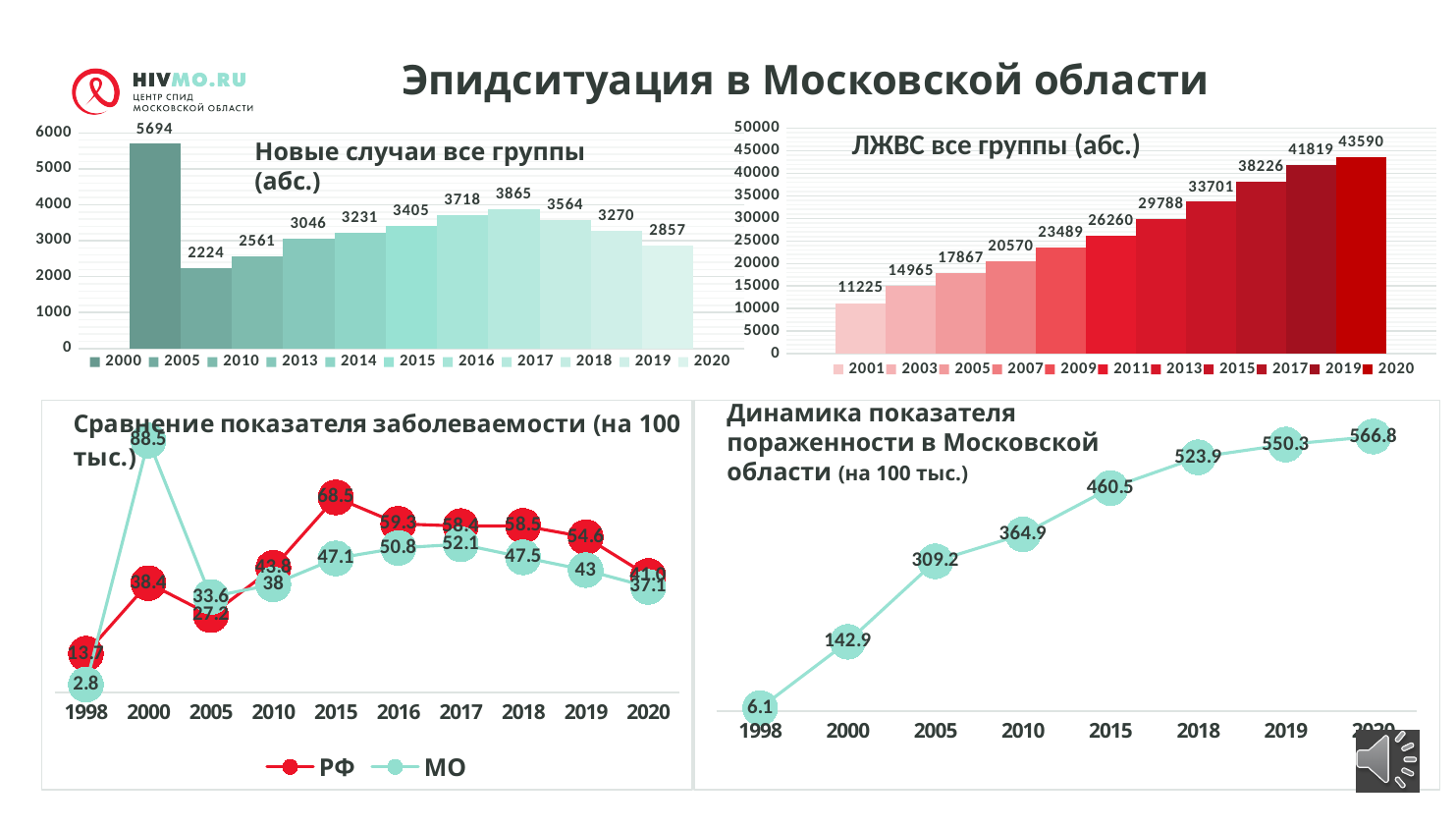
In the chart 'Новые случаи все группы (абс.)', what is the difference between the values for 2019 and 2020? 413 In the chart 'ЛЖВС все группы (абс.)', do the values rise or fall from 2001 to 2020? rise In the chart 'Сравнение показателя заболеваемости (на 100 тыс.)', what is the value for МО in 2017? 52.1 In the chart 'Сравнение показателя заболеваемости (на 100 тыс.)', which series has the larger value in 2015, РФ or МО? РФ In the chart 'Новые случаи все группы (абс.)', which year has the lowest value? 2005 In the chart 'Новые случаи все группы (абс.)', which year has the highest value? 2000 In the chart 'ЛЖВС все группы (абс.)', how many bars are plotted? 11 In the chart 'Новые случаи все группы (абс.)', what is the value for 2017? 3865 In the chart 'Динамика показателя пораженности в Московской области (на 100 тыс.)', what is the value for 2015? 460.5 In the chart 'ЛЖВС все группы (абс.)', what is the value for 2013? 29788 In the chart 'Сравнение показателя заболеваемости (на 100 тыс.)', how many series does the legend list? 2 What kind of chart is 'ЛЖВС все группы (абс.)'? bar chart